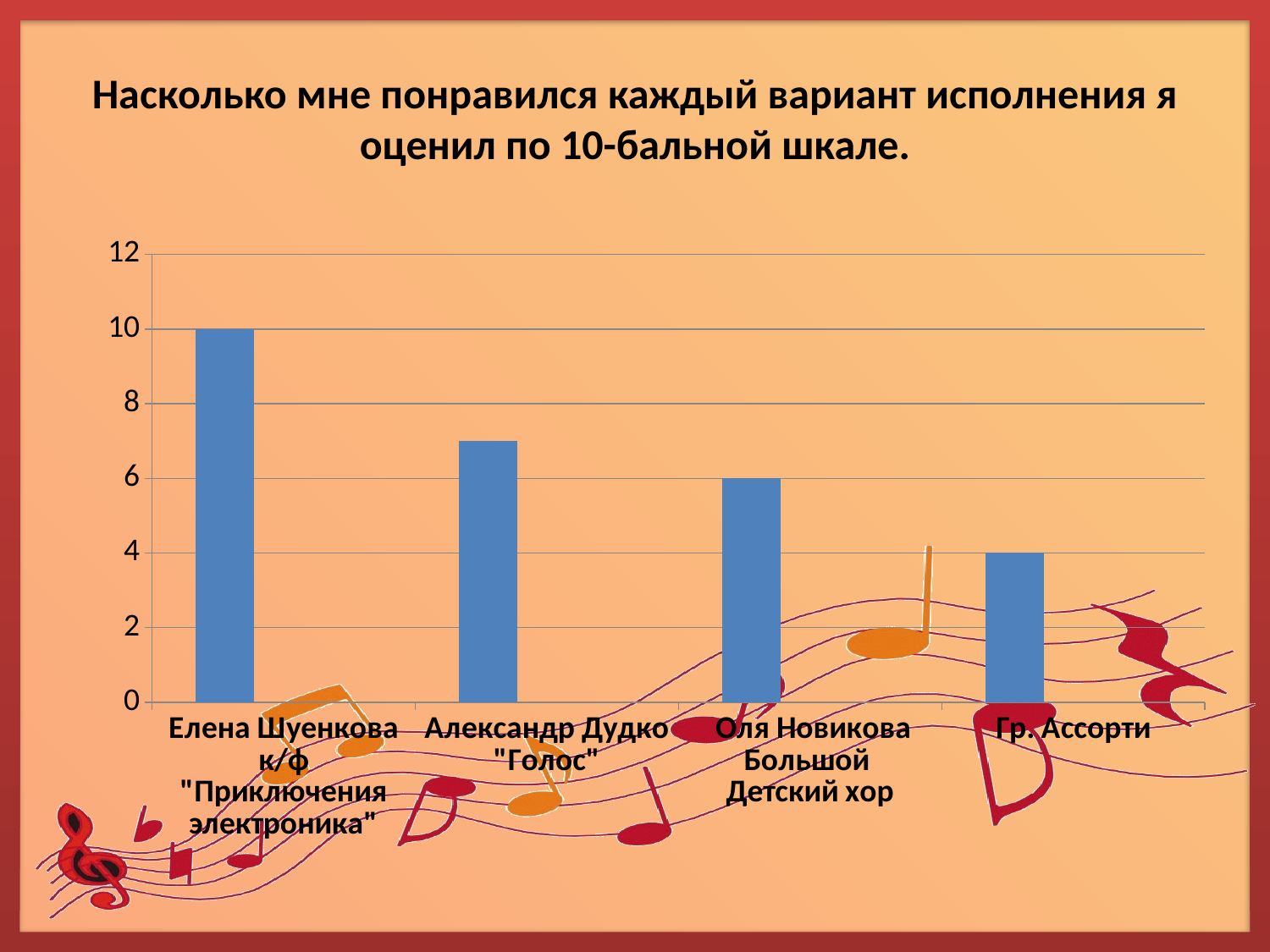
How many categories (performers) are shown on the chart? 4 Which performer has the highest score on the chart? Елена Шуенкова Is the value for Александр Дудко ("Голос") greater or less than 8? less Which performer has the lowest score on the chart? Гр. Ассорти What is the difference between the scores of Елена Шуенкова and Гр. Ассорти? 6 What score does Елена Шуенкова (к/ф "Приключения электроника") receive on the chart? 10 Is the value for Александр Дудко ("Голос") greater or less than 6? greater What score does Гр. Ассорти receive on the chart? 4 What score does Оля Новикова (Большой Детский хор) receive on the chart? 6 Do the values rise or fall from left to right along the x axis? Fall Which has a higher score: Оля Новикова or Гр. Ассорти? Оля Новикова What kind of chart is shown on the slide? Bar chart